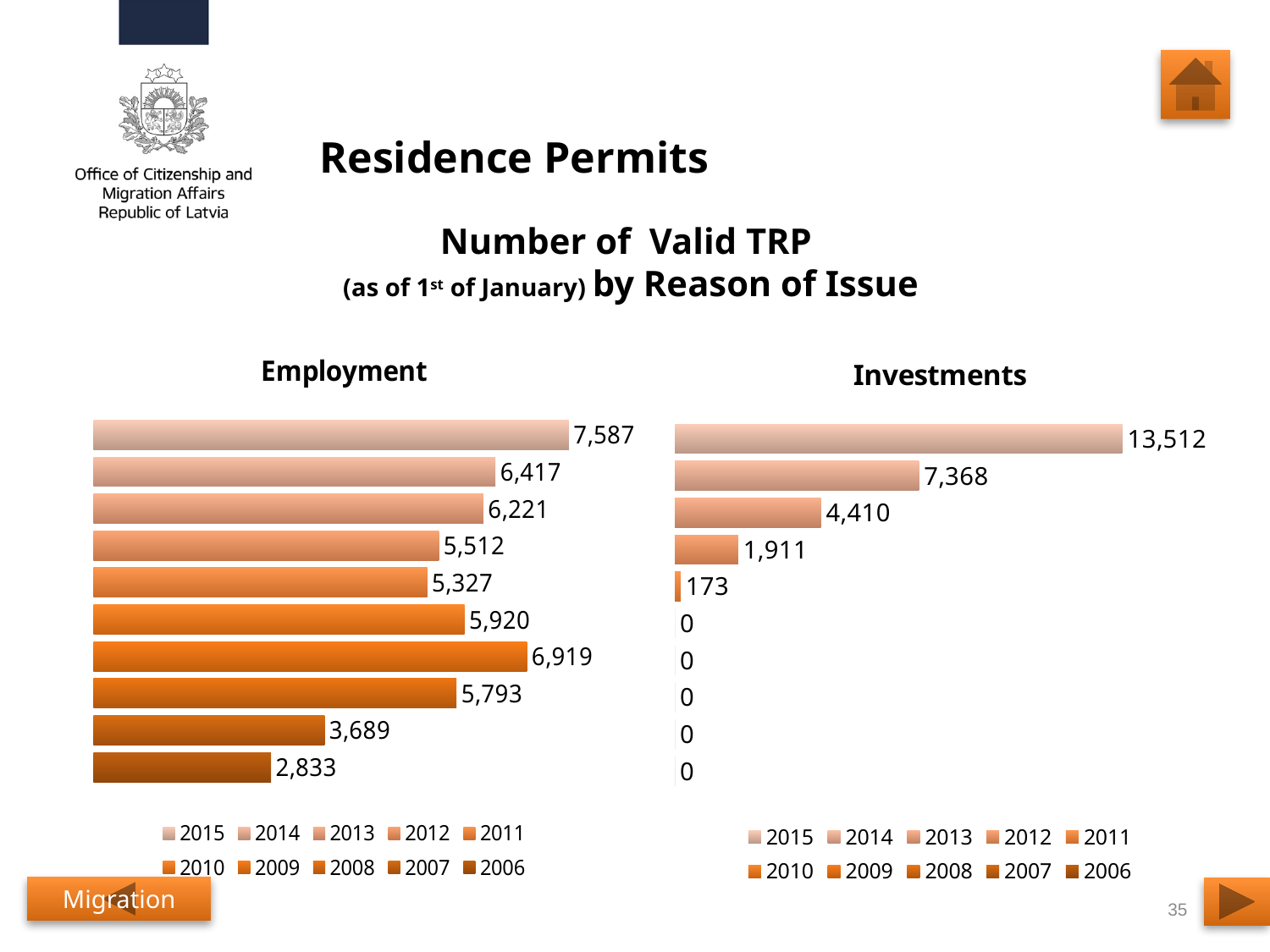
In the Investments chart, how many years show a value of 0? 5 In the Investments chart, what is the value for 2011 (the fifth bar from the top)? 173 In the Investments chart, which year has the highest value? 2015 In the Employment chart, which year has the lowest value? 2006 In the Investments chart, what is the difference between the 2015 value (13,512) and the 2014 value (7,368)? 6,144 In the Employment chart, which is larger: the value for 2009 (6,919) or the value for 2014 (6,417)? 2009 How many bars are plotted in the Employment chart? 10 In the Employment chart, what is the value of the top bar (2015)? 7,587 What type of chart is the Employment chart? Bar chart In the Employment chart, what is the difference between the 2015 value (7,587) and the 2006 value (2,833)? 4,754 In the Investments chart, what is the value for 2015 (the top bar)? 13,512 How many entries does the legend of the Investments chart list? 10